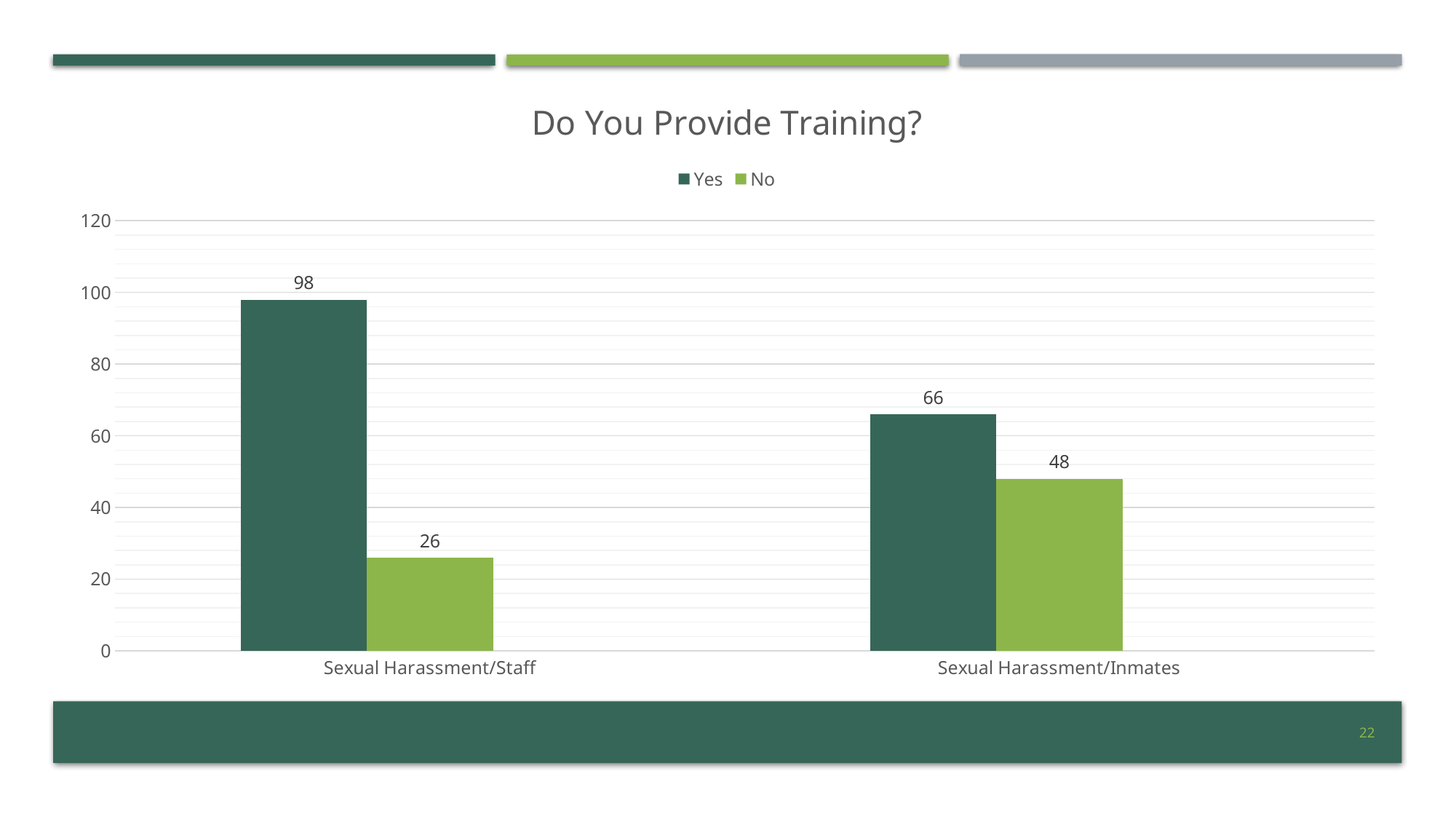
Which category has the lowest No value? Sexual Harassment/Staff What is the difference between the Yes and No values for Sexual Harassment/Staff? 72 What is the Yes value for Sexual Harassment/Staff? 98 Which category has the highest Yes value? Sexual Harassment/Staff How many series does the legend list? 2 What is the difference between the Yes values for Sexual Harassment/Staff and Sexual Harassment/Inmates? 32 What is the Yes value for Sexual Harassment/Inmates? 66 What is the No value for Sexual Harassment/Inmates? 48 What is the No value for Sexual Harassment/Staff? 26 Which is larger for Sexual Harassment/Inmates, the Yes value or the No value? Yes How many categories are shown on the x axis? 2 What kind of chart is shown on the slide? Bar chart